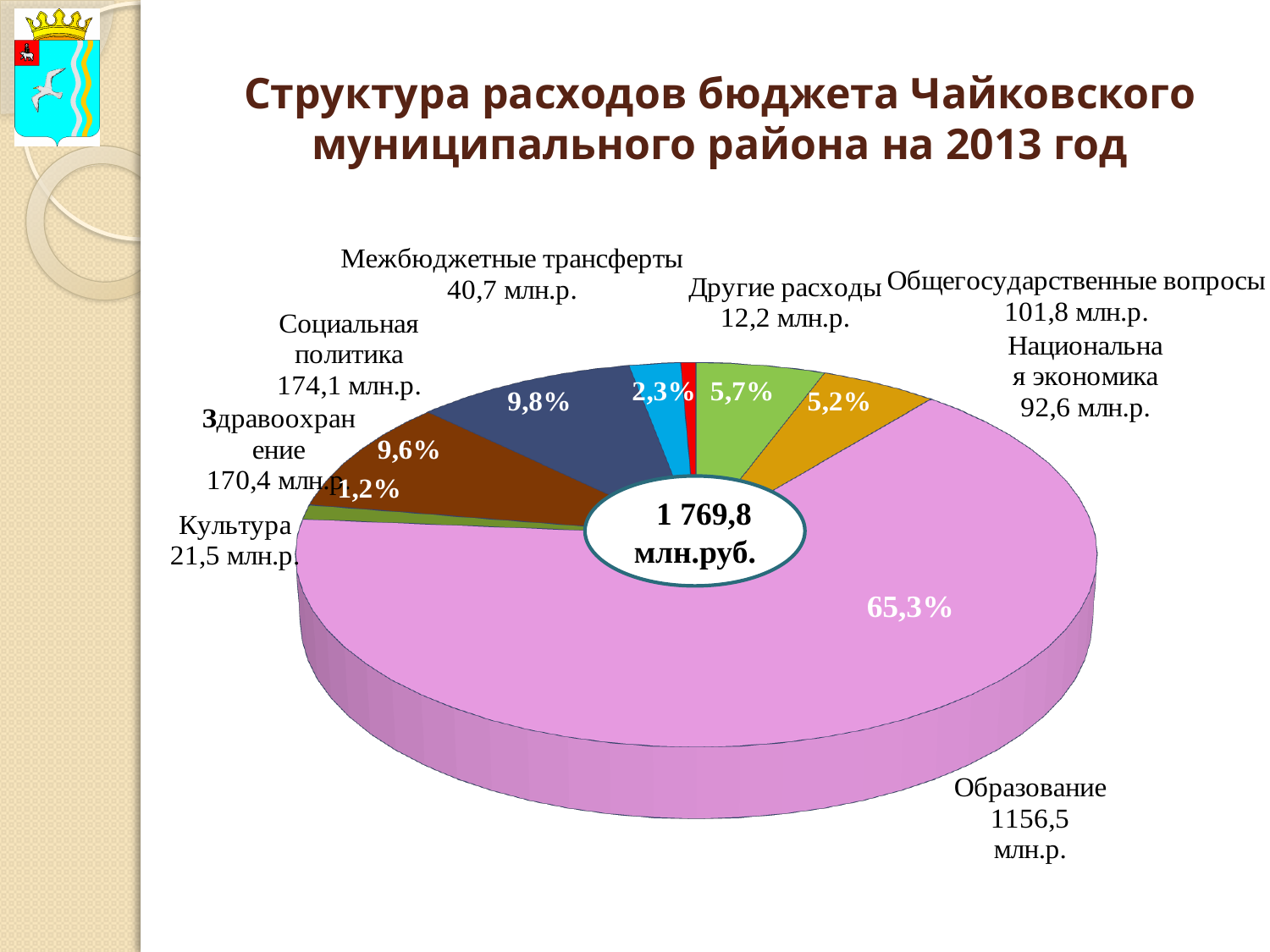
What share of the pie does Образование account for? 65,3% What is the value for Национальная экономика? 92,6 млн.р. What share of the pie does Здравоохранение account for? 9,6% Which is larger, Общегосударственные вопросы or Национальная экономика? Общегосударственные вопросы What is the value for Образование? 1156,5 млн.р. How many expenditure categories are shown in the pie chart? 8 What is the difference between Социальная политика and Здравоохранение? 3,7 млн.р. What kind of chart is shown on the slide? Pie chart What is the value for Межбюджетные трансферты? 40,7 млн.р. What is the value for Социальная политика? 174,1 млн.р. Which category has the largest share of the budget expenditures? Образование Which category has the smallest value? Другие расходы